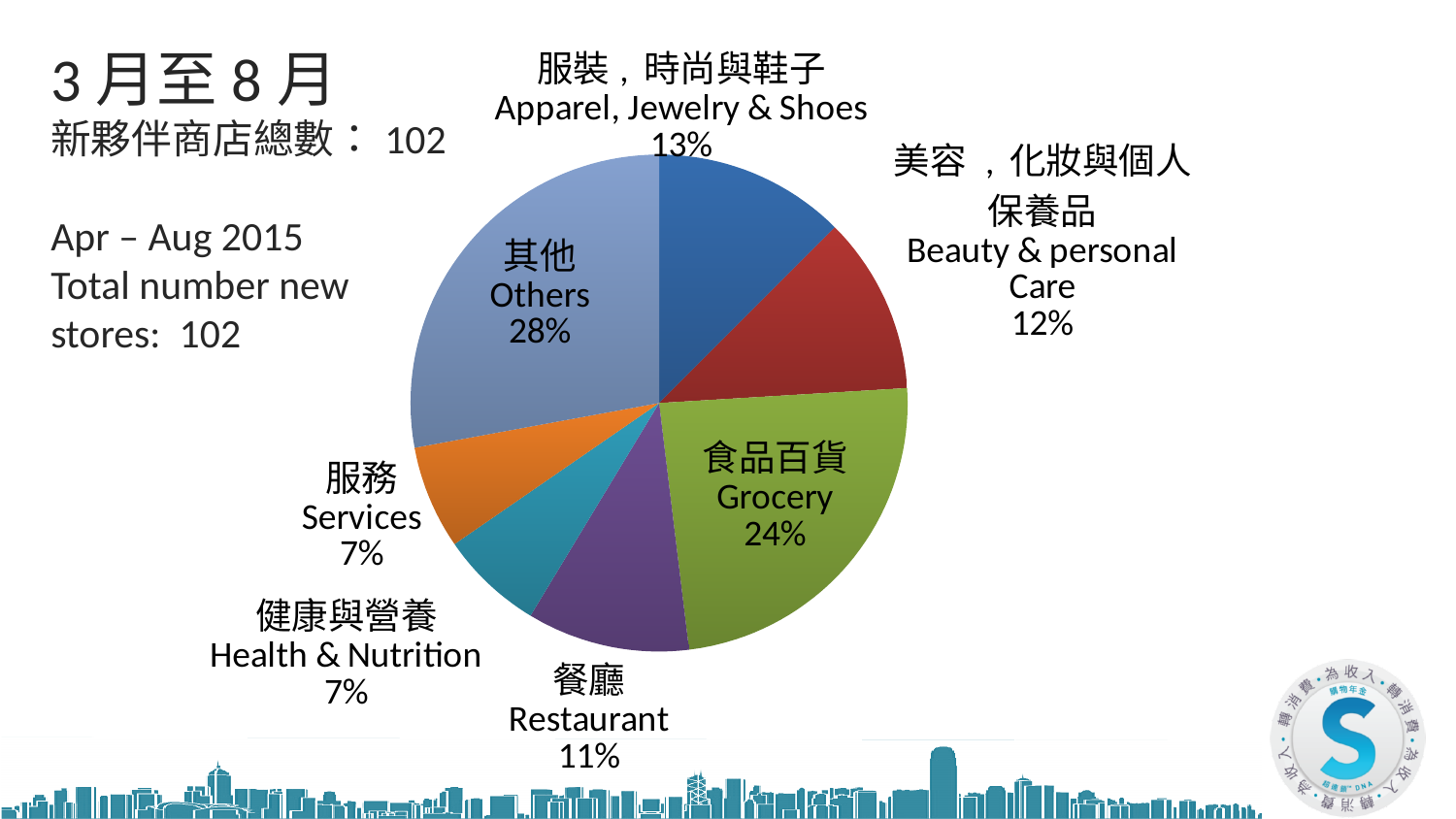
What period does the chart cover according to the slide? Apr – Aug 2015 What is the total number of new stores stated on the slide? 102 Which category has the largest share among the named (non-Others) categories? Grocery What percentage is shown for Beauty & personal Care? 12% What is the difference in percentage points between Others and Grocery? 4 Which two categories share the smallest percentage on the pie? Services and Health & Nutrition How many categories are shown in the pie chart? 7 What type of chart is shown on the slide? Pie chart What share of new stores does the Grocery slice represent? 24% Which is larger, the Apparel, Jewelry & Shoes slice or the Restaurant slice? Apparel, Jewelry & Shoes What percentage is shown for the Restaurant slice? 11% Which category has the largest slice of the pie? Others